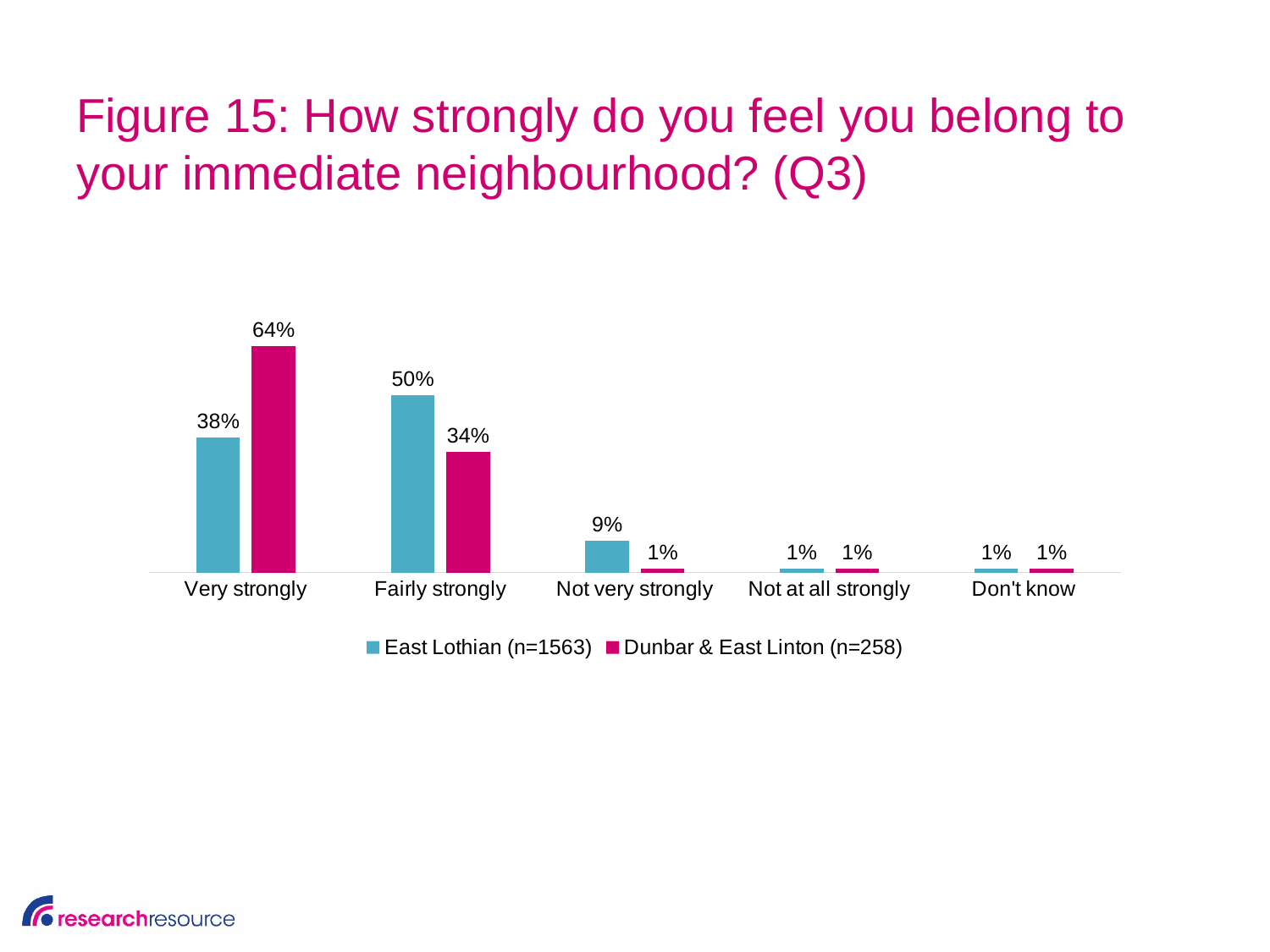
Which category has the highest value for the East Lothian series? Fairly strongly How many series does the legend list? 2 What is the difference between the Dunbar & East Linton and East Lothian values for 'Very strongly'? 26 percentage points What percentage of East Lothian respondents said they feel they belong 'Very strongly' to their immediate neighbourhood? 38% For 'Not very strongly', which series has the larger value, East Lothian or Dunbar & East Linton? East Lothian What type of chart is shown on the slide? Bar chart Which category has the highest value for the Dunbar & East Linton series? Very strongly How many response categories are shown on the x axis? 5 What is the value for East Lothian in the 'Fairly strongly' category? 50% What is the difference between the East Lothian and Dunbar & East Linton values for 'Fairly strongly'? 16 percentage points What is the value for Dunbar & East Linton in the 'Not very strongly' category? 1% What percentage of Dunbar & East Linton respondents said 'Very strongly'? 64%